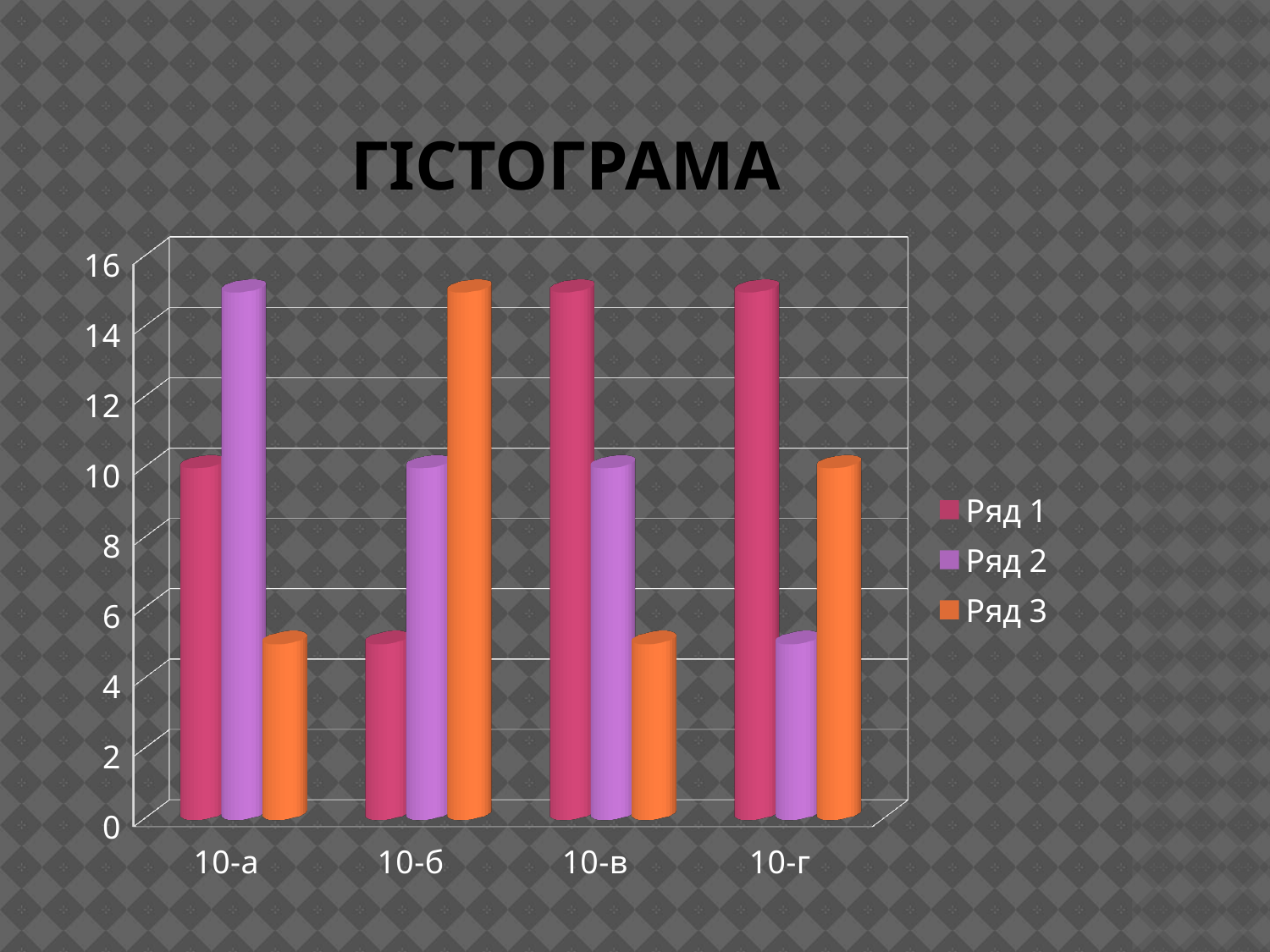
Is the value of Ряд 3 for 10-б greater or less than 14? greater For which category is the value of Ряд 2 the highest? 10-а How many categories are shown on the x axis? 4 For which category is the value of Ряд 3 the highest? 10-б Which is larger for category 10-г: the value of Ряд 1 or the value of Ряд 2? Ряд 1 For which category is the value of Ряд 1 the lowest? 10-б What kind of chart is shown on the slide? bar chart What is the title of the chart? ГІСТОГРАМА How many series does the legend list? 3 Which series has the lowest value for category 10-а? Ряд 3 Is the value of Ряд 1 for 10-б greater or less than 6? less Which series has the highest value for category 10-а? Ряд 2